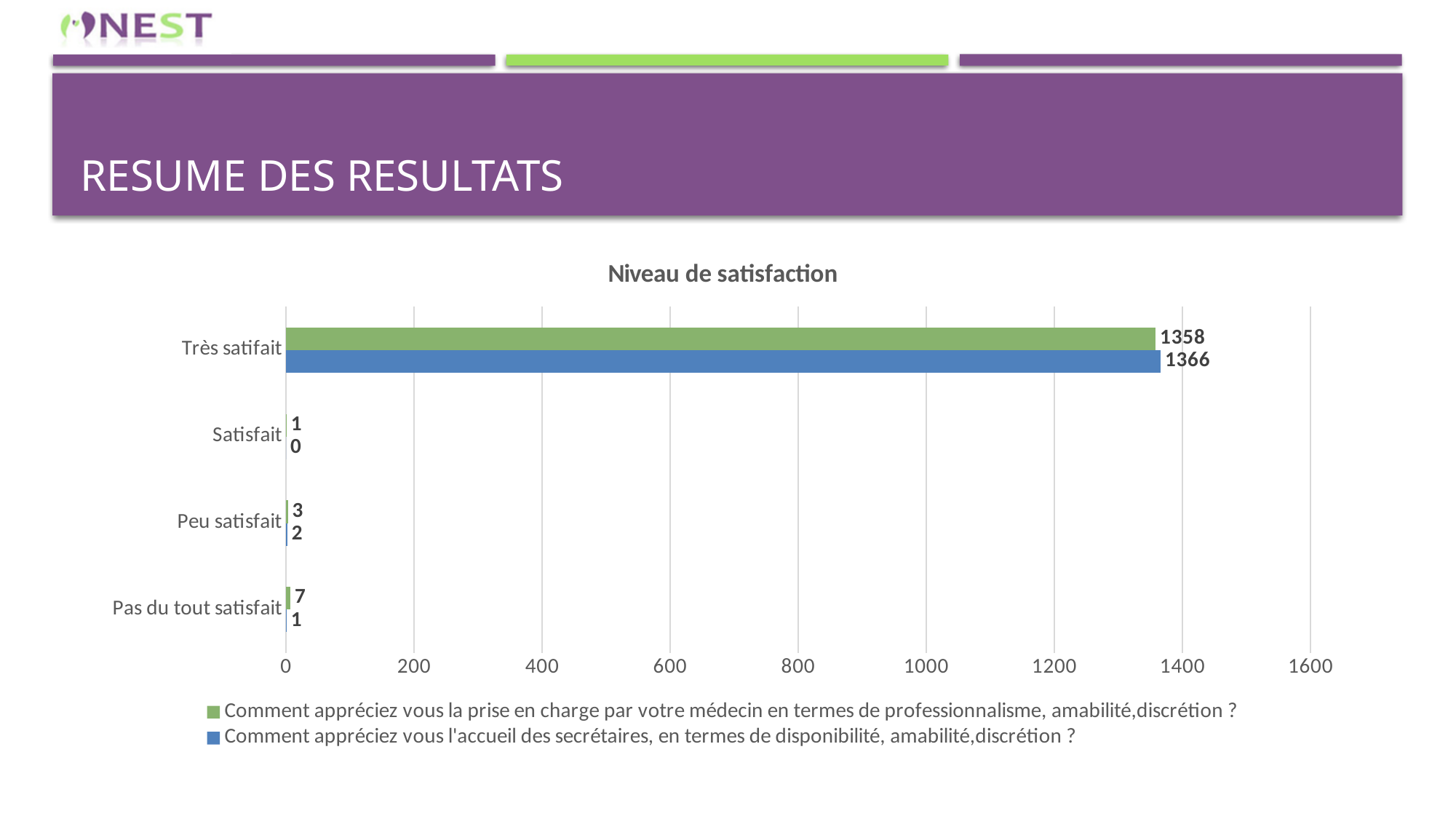
What is the difference between the two series' values for 'Très satifait'? 8 Which category has the highest value in the series about the secrétaires (blue)? Très satifait How many series does the legend list? 2 What is the value for 'Satisfait' in the series about the secrétaires (blue)? 0 Is the value for 'Très satifait' in the series about the médecin (green) greater or less than 1200? greater What kind of chart is shown on the slide? bar chart How many categories are shown on the chart? 4 What is the value for 'Très satifait' in the series about the médecin (green)? 1358 Which category has the lowest value in the series about the médecin (green)? Satisfait For 'Peu satisfait', which series has the larger value, the médecin (green) or the secrétaires (blue)? médecin (green) What is the value for 'Très satifait' in the series about the secrétaires (blue)? 1366 What is the value for 'Pas du tout satisfait' in the series about the médecin (green)? 7